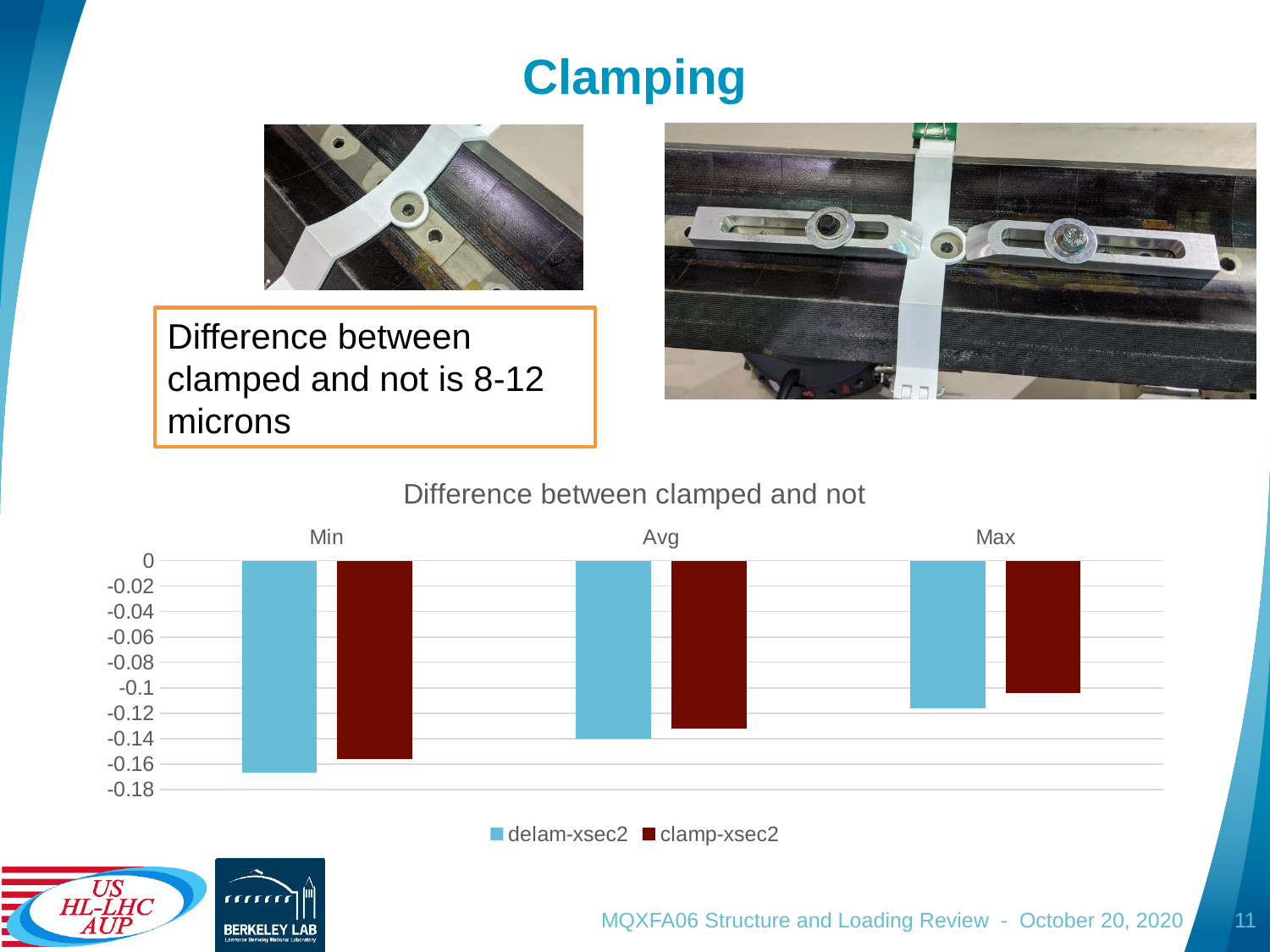
Do the delam-xsec2 values rise or fall (move toward zero or away from it) going from Min to Max along the x axis? rise What type of chart is shown on the slide? bar chart Is the clamp-xsec2 value for Min greater or less than -0.14? less How many series does the chart legend list? 2 Is the delam-xsec2 value for Avg greater or less than -0.12? less Which category has the highest (closest to zero) clamp-xsec2 value? Max In the Max category, which series has the value closer to zero, delam-xsec2 or clamp-xsec2? clamp-xsec2 In the Min category, which series has the lower (more negative) value, delam-xsec2 or clamp-xsec2? delam-xsec2 How many categories are shown on the x axis of the chart? 3 What is the title of the chart? Difference between clamped and not Which series is shown in dark red in the chart? clamp-xsec2 Which category has the lowest (most negative) delam-xsec2 value? Min